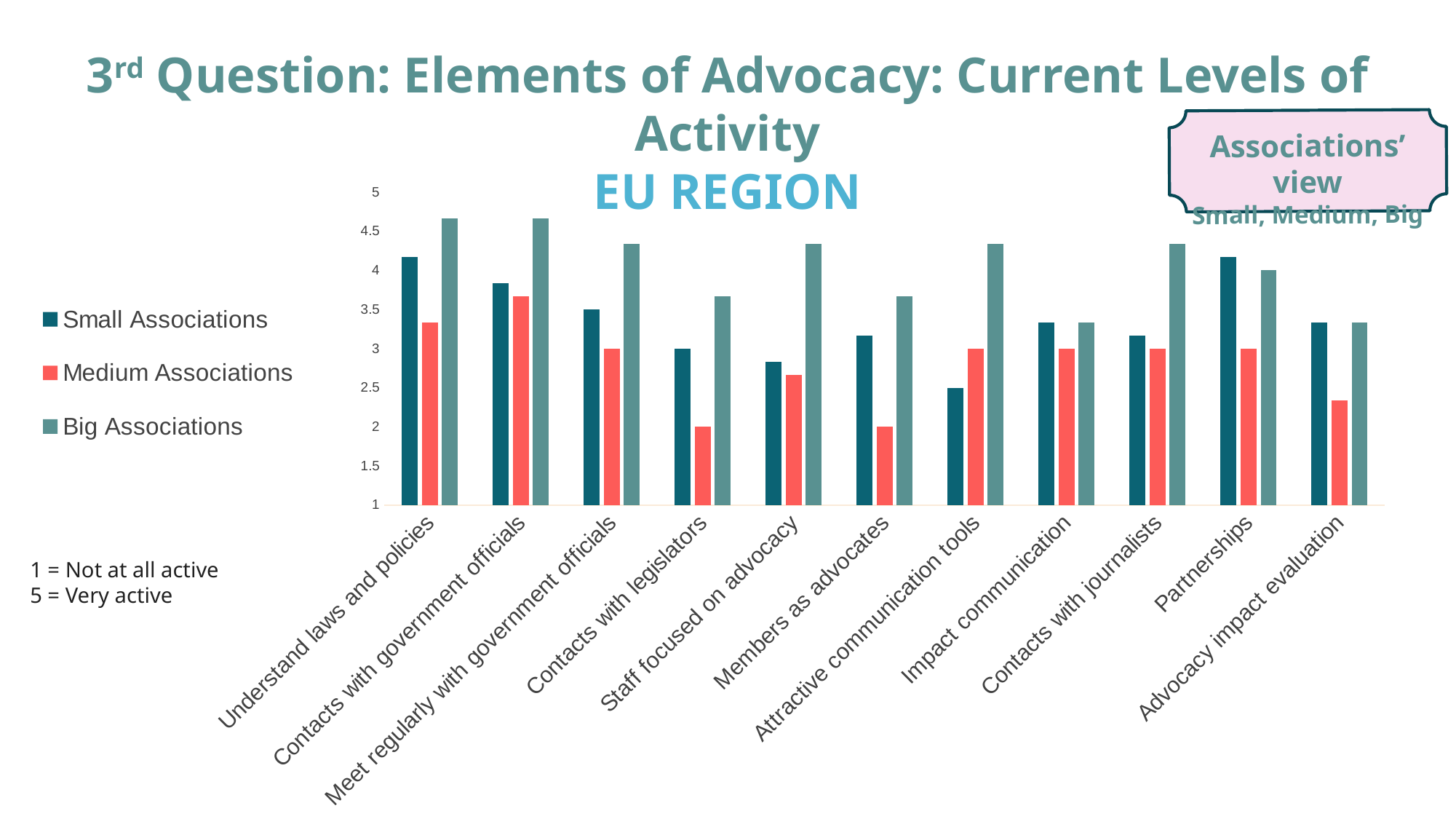
What is the value for Small Associations for Attractive communication tools? 2.5 Is the value for Medium Associations for Advocacy impact evaluation greater or less than 2.5? less Is the value for Small Associations for Staff focused on advocacy greater or less than 3? less Which series is shown in red? Medium Associations How many categories are shown along the x axis? 11 Is the value for Big Associations for Understand laws and policies greater or less than 4.5? greater Which is larger for Understand laws and policies: Small Associations or Medium Associations? Small Associations How many series does the legend list? 3 Which region does the chart cover, according to the subtitle? EU REGION What kind of chart is shown on the slide? bar chart What is the value for Medium Associations for Contacts with legislators? 2 What is the value for Big Associations for Partnerships? 4